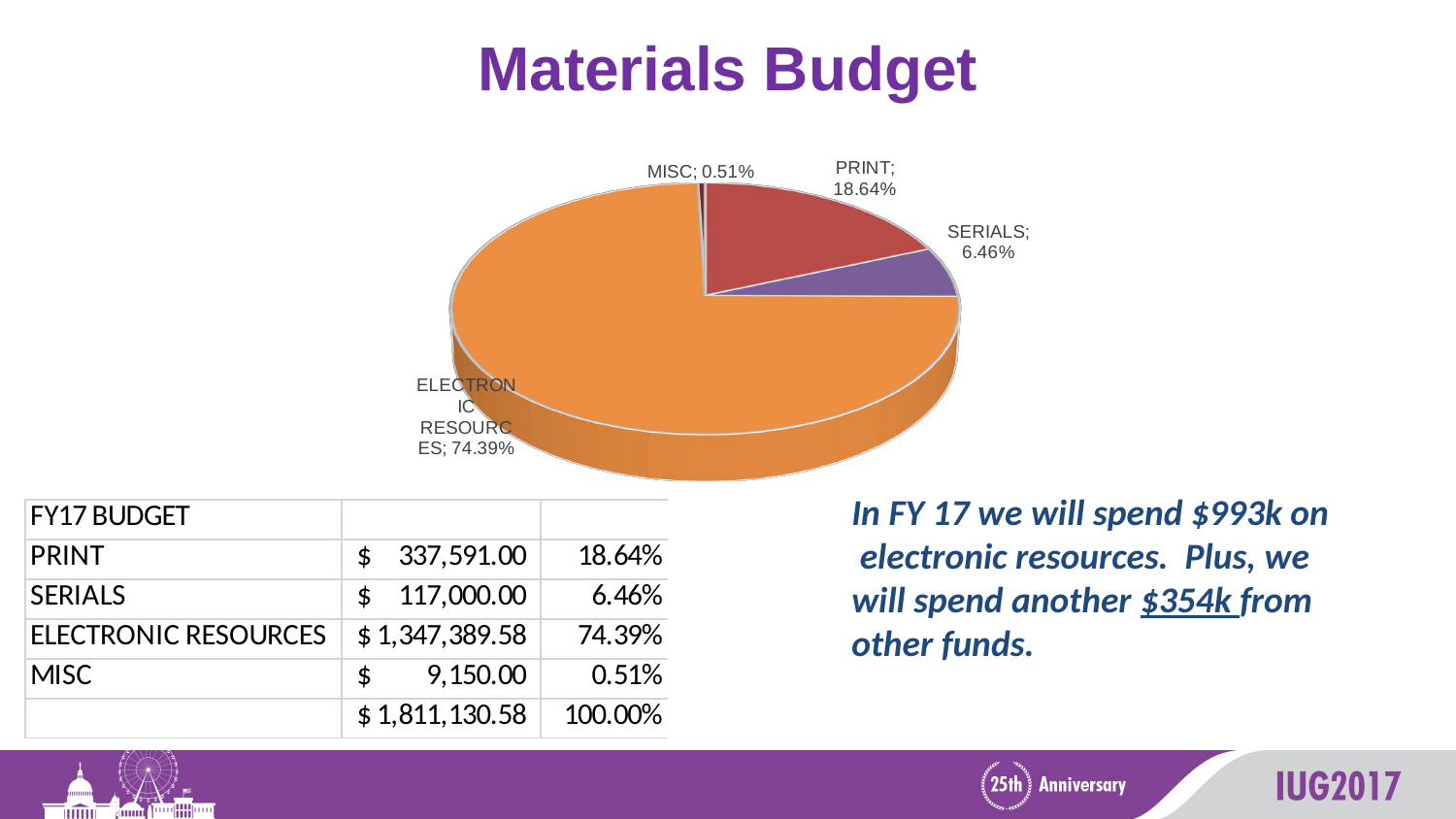
What share of the pie does SERIALS take? 6.46% What share of the pie does ELECTRONIC RESOURCES take? 74.39% What colour is the ELECTRONIC RESOURCES slice? orange Which slice is larger, PRINT or SERIALS? PRINT How many slices does the pie chart have? 4 Which category has the smallest slice of the pie? MISC What share of the pie does MISC take? 0.51% What is the difference in percentage points between the PRINT and SERIALS slices? 12.18% What kind of chart is shown on the slide? pie chart What is the title of the slide containing the pie chart? Materials Budget Which category has the largest slice of the pie? ELECTRONIC RESOURCES